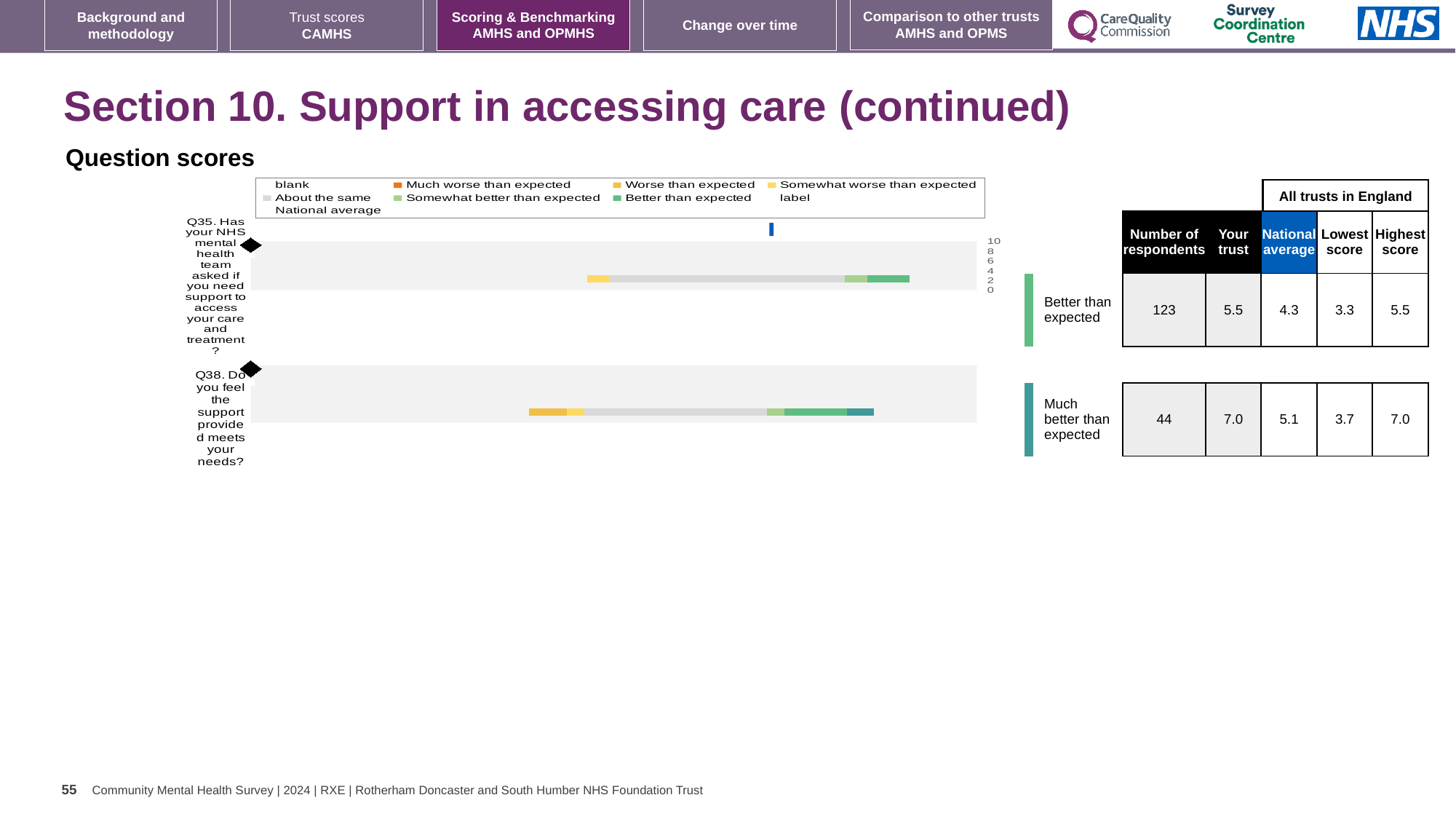
According to the table, what is the lowest score among all trusts in England for Q38? 3.7 According to the table, what is the trust's score for Q35 (Has your NHS mental health team asked if you need support to access your care and treatment?)? 5.5 According to the table, which question has the higher trust score, Q35 or Q38? Q38 According to the table, what is the national average for Q38? 5.1 How many questions (categories) are plotted in the question scores chart? 2 Which legend entry in the question scores chart is shown in orange? Much worse than expected Which legend entry in the question scores chart is shown in light grey? About the same What kind of chart is used to show the question scores on this slide? bar chart How many entries does the legend of the question scores chart list? 9 According to the table, how many respondents answered Q35? 123 According to the table, what is the trust's score for Q38 (Do you feel the support provided meets your needs?)? 7.0 According to the table, what is the difference between the trust's score and the national average for Q35? 1.2